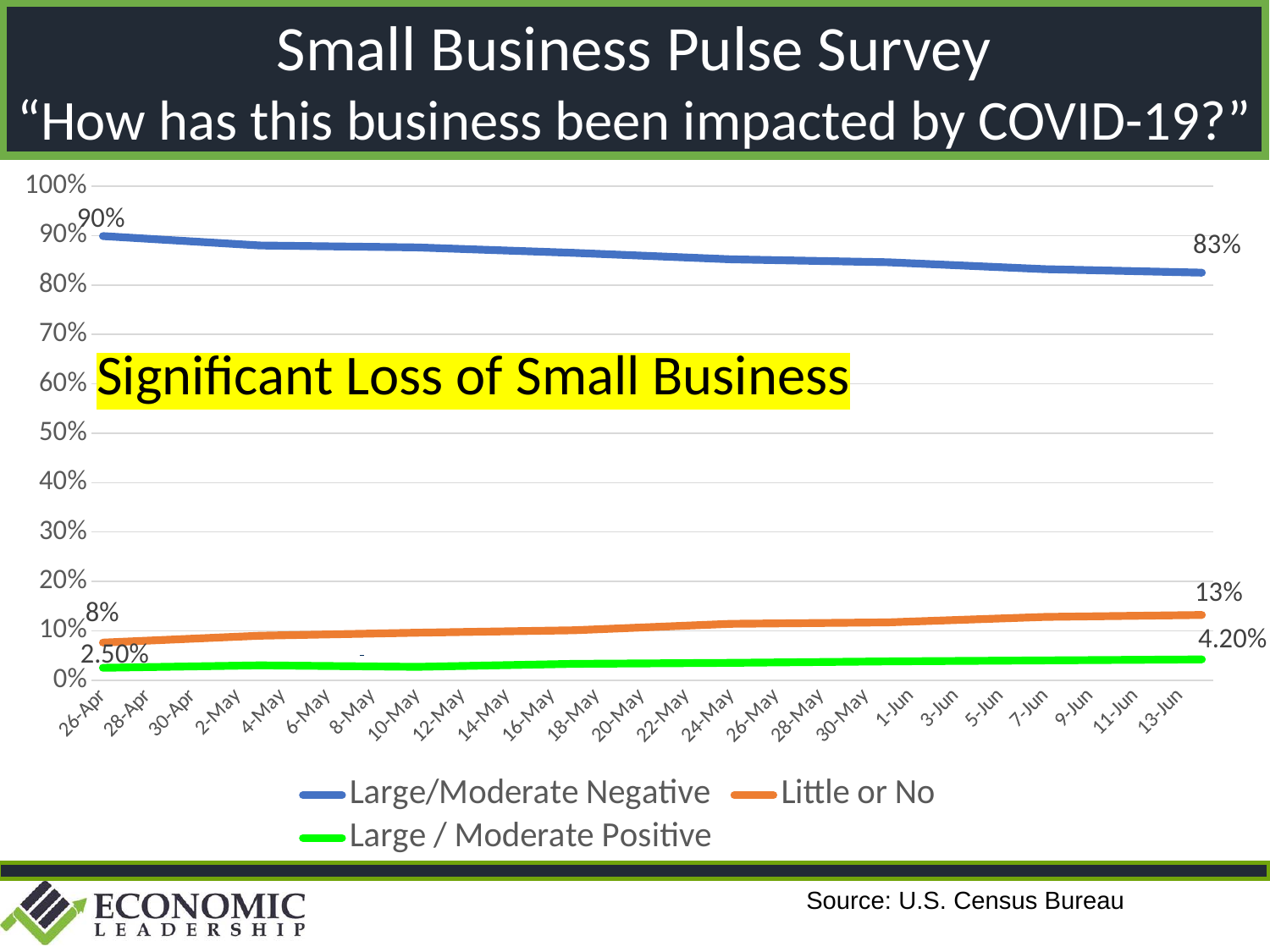
What text is highlighted in yellow on the chart? Significant Loss of Small Business What kind of chart is shown on the slide? Line chart What is the value of the Little or No series on 26-Apr? 8% How many series does the legend list? 3 Is the value of the Large/Moderate Negative series on 20-May greater or less than 80%? greater Does the Large/Moderate Negative series rise or fall from 26-Apr to 13-Jun? Fall What is the value of the Large/Moderate Negative series on 26-Apr? 90% On 13-Jun, which series has the larger value: Little or No or Large / Moderate Positive? Little or No What is the value of the Little or No series on 13-Jun? 13% What is the value of the Large / Moderate Positive series on 13-Jun? 4.20% By how many percentage points did the Large/Moderate Negative series fall from 26-Apr to 13-Jun? 7 percentage points What is the value of the Large/Moderate Negative series on 13-Jun? 83%